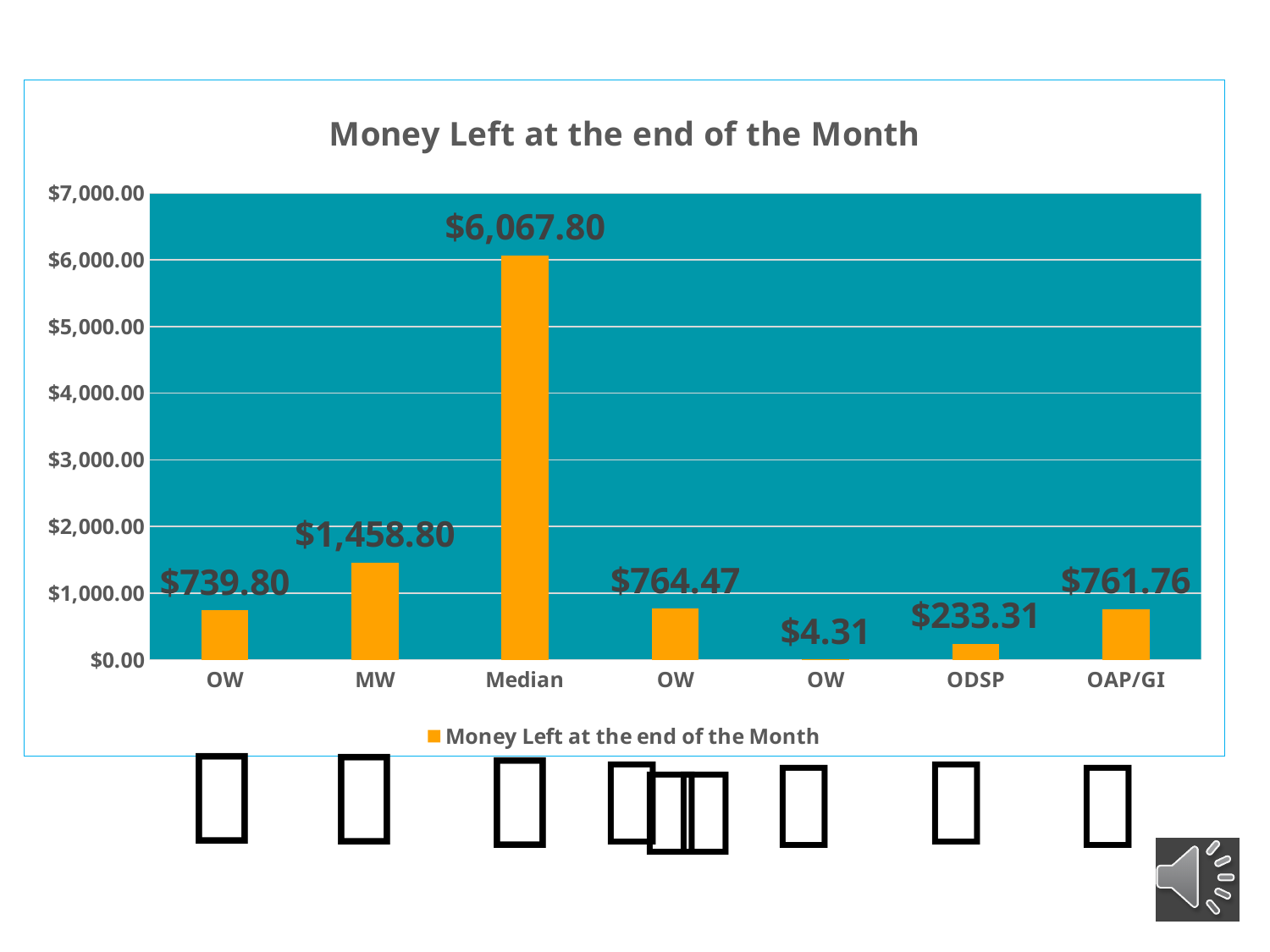
What is the value of the first bar on the left (OW)? $739.80 What is the lowest value shown on the chart? $4.31 What is the value for ODSP? $233.31 Which is larger, the value for MW or the value for OAP/GI? MW What is the difference between the values for OAP/GI and ODSP? $528.45 How many bars are shown on the chart? 7 Which category has the highest value? Median What is the value for OAP/GI? $761.76 What is the value for MW? $1,458.80 What is the difference between the values for Median and MW? $4,609.00 What is the value for Median? $6,067.80 What kind of chart is this? Bar chart